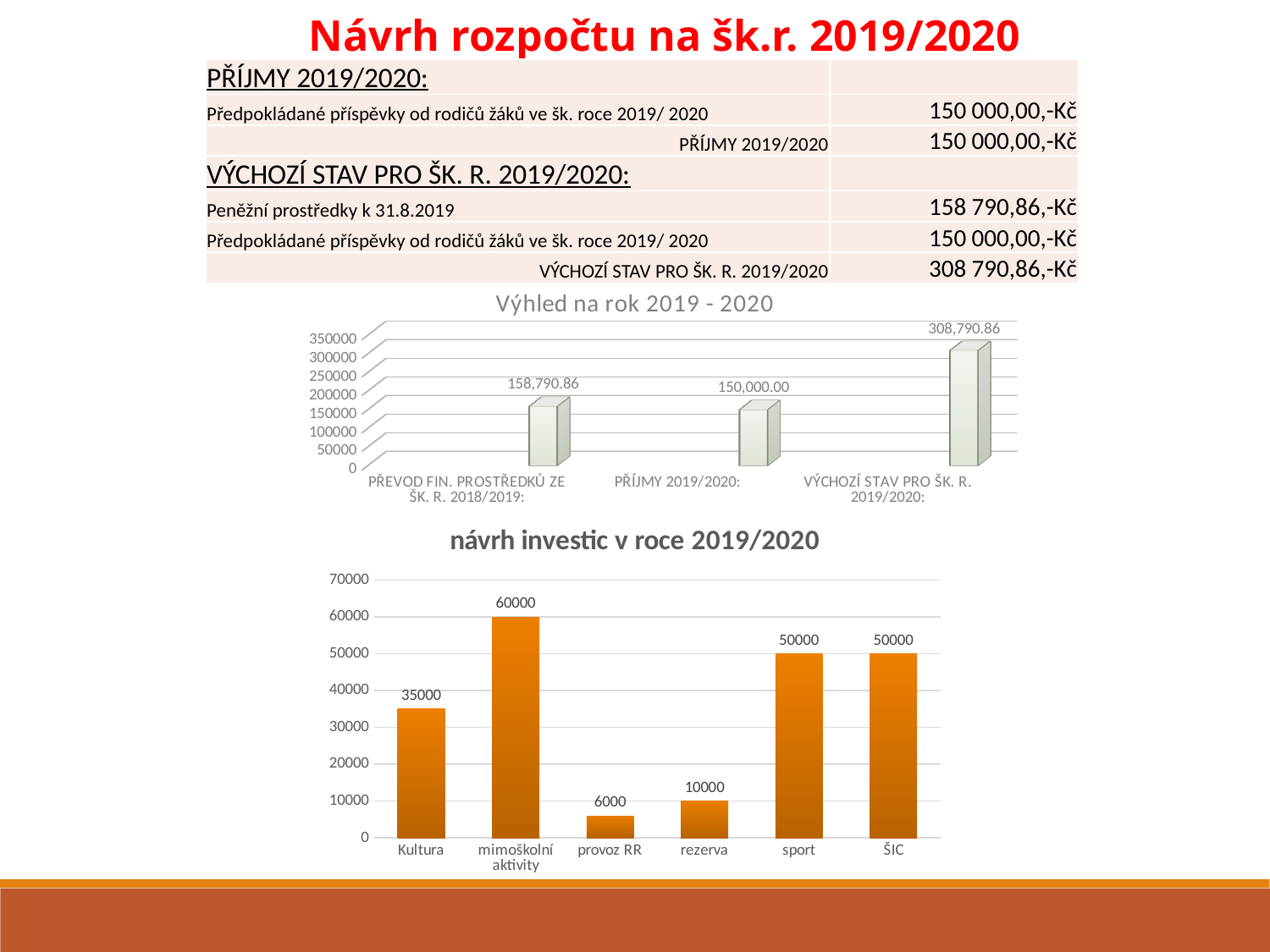
In the chart 'návrh investic v roce 2019/2020', which category has the lowest value? provoz RR In the chart 'návrh investic v roce 2019/2020', what is the value for provoz RR? 6000 In the chart 'návrh investic v roce 2019/2020', which is larger: the value for Kultura or the value for sport? sport In the chart 'návrh investic v roce 2019/2020', which category has the highest value? mimoškolní aktivity What kind of chart is 'Výhled na rok 2019 - 2020'? bar chart In the chart 'návrh investic v roce 2019/2020', how many categories are shown? 6 In the chart 'Výhled na rok 2019 - 2020', which category has the highest value? VÝCHOZÍ STAV PRO ŠK. R. 2019/2020 In the chart 'návrh investic v roce 2019/2020', what is the total of the values for sport and ŠIC? 100000 In the chart 'Výhled na rok 2019 - 2020', what is the value for VÝCHOZÍ STAV PRO ŠK. R. 2019/2020? 308,790.86 In the chart 'návrh investic v roce 2019/2020', what is the value for Kultura? 35000 In the chart 'návrh investic v roce 2019/2020', what is the difference between the values for mimoškolní aktivity and rezerva? 50000 In the chart 'Výhled na rok 2019 - 2020', what is the value for PŘÍJMY 2019/2020? 150,000.00